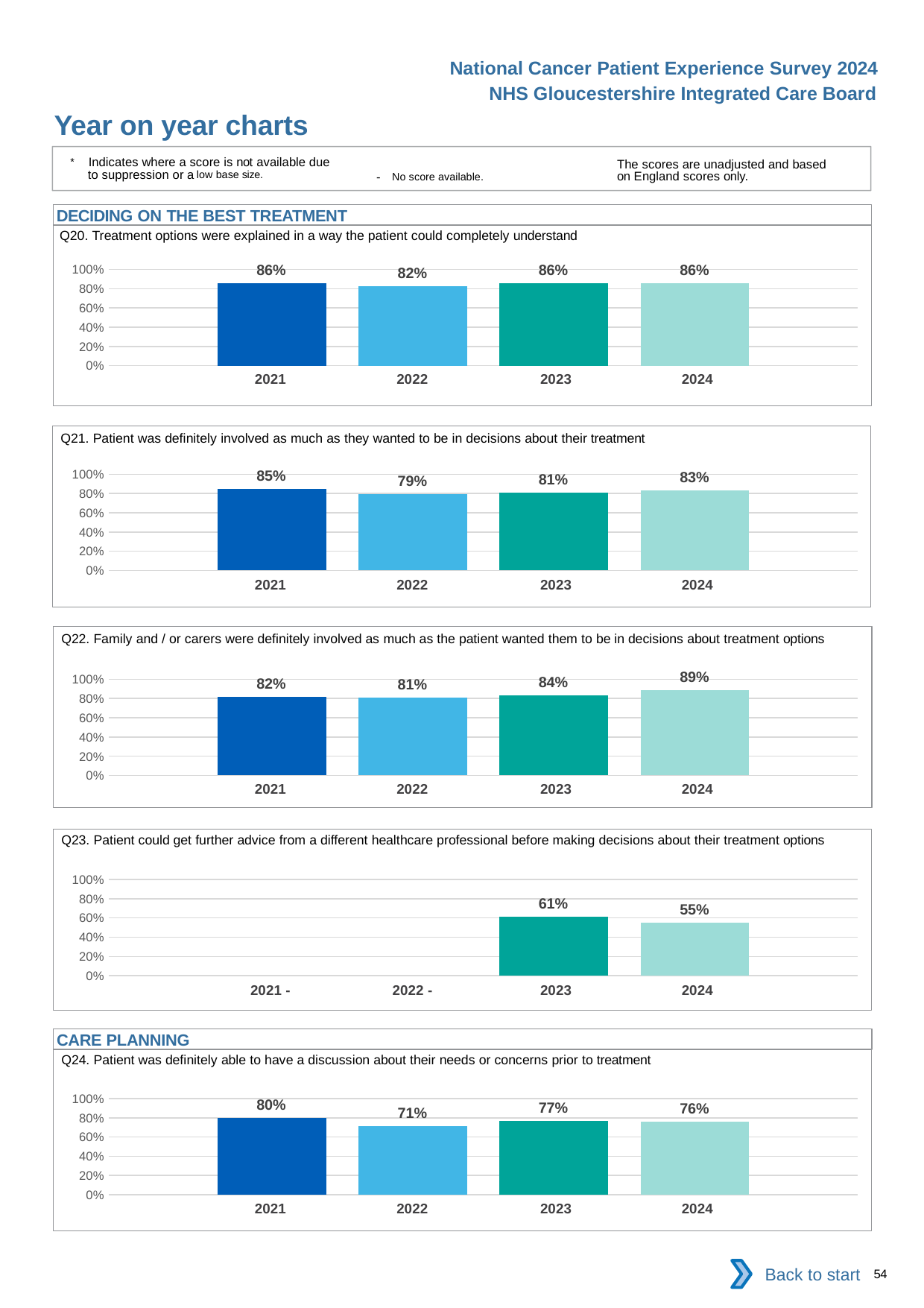
In the Q23 chart, how many years have a bar plotted? 2 What type of chart is used for Q20? Bar chart In the Q24 chart, what is the difference between the 2021 and 2022 values? 9 percentage points In the Q23 chart, what is the value for 2023? 61% In the Q21 chart, which year has the lowest value? 2022 In the Q20 chart, what is the value for 2022? 82% In the Q22 chart, which year has the highest value? 2024 In the Q22 chart, what is the difference between the 2024 and 2021 values? 7 percentage points In the Q21 chart, do the values rise or fall from 2022 to 2024? rise In the Q23 chart, is the value for 2024 larger or smaller than the value for 2023? smaller In the Q21 chart, which year has the highest value? 2021 In the Q24 chart, what is the value for 2022? 71%